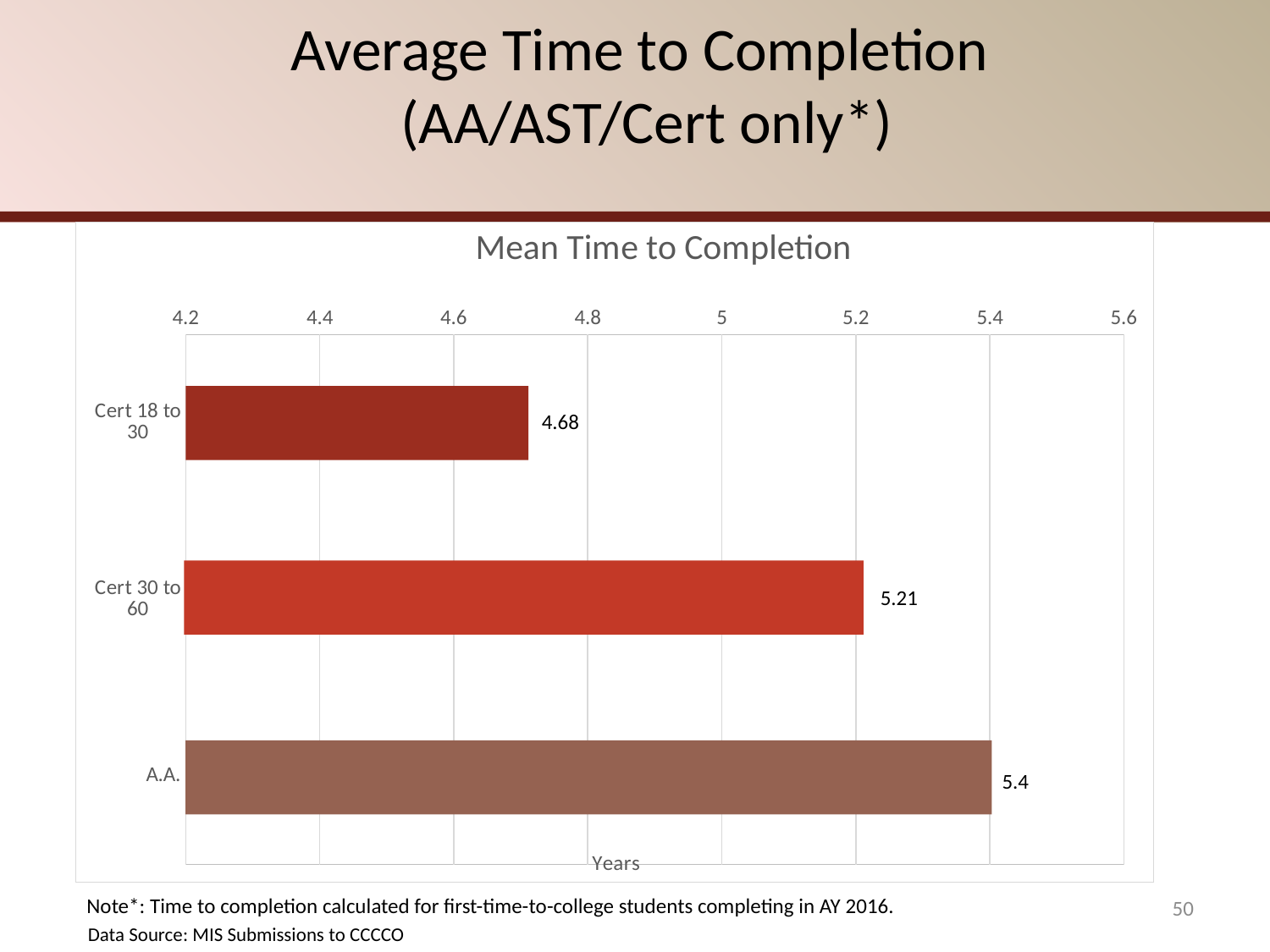
How many categories are shown in the chart? 3 Which category has the highest mean time to completion? A.A. What is the mean time to completion for A.A.? 5.4 What is the mean time to completion for Cert 30 to 60? 5.21 Which has a larger mean time to completion, Cert 30 to 60 or A.A.? A.A. What is the difference between the mean time to completion for Cert 30 to 60 and Cert 18 to 30? 0.53 Which category has the lowest mean time to completion? Cert 18 to 30 Is the value for Cert 18 to 30 greater or less than 5? less What kind of chart is shown on the slide? bar chart What is the mean time to completion for Cert 18 to 30? 4.68 What is the title of the chart? Mean Time to Completion What is the difference between the mean time to completion for A.A. and Cert 18 to 30? 0.72